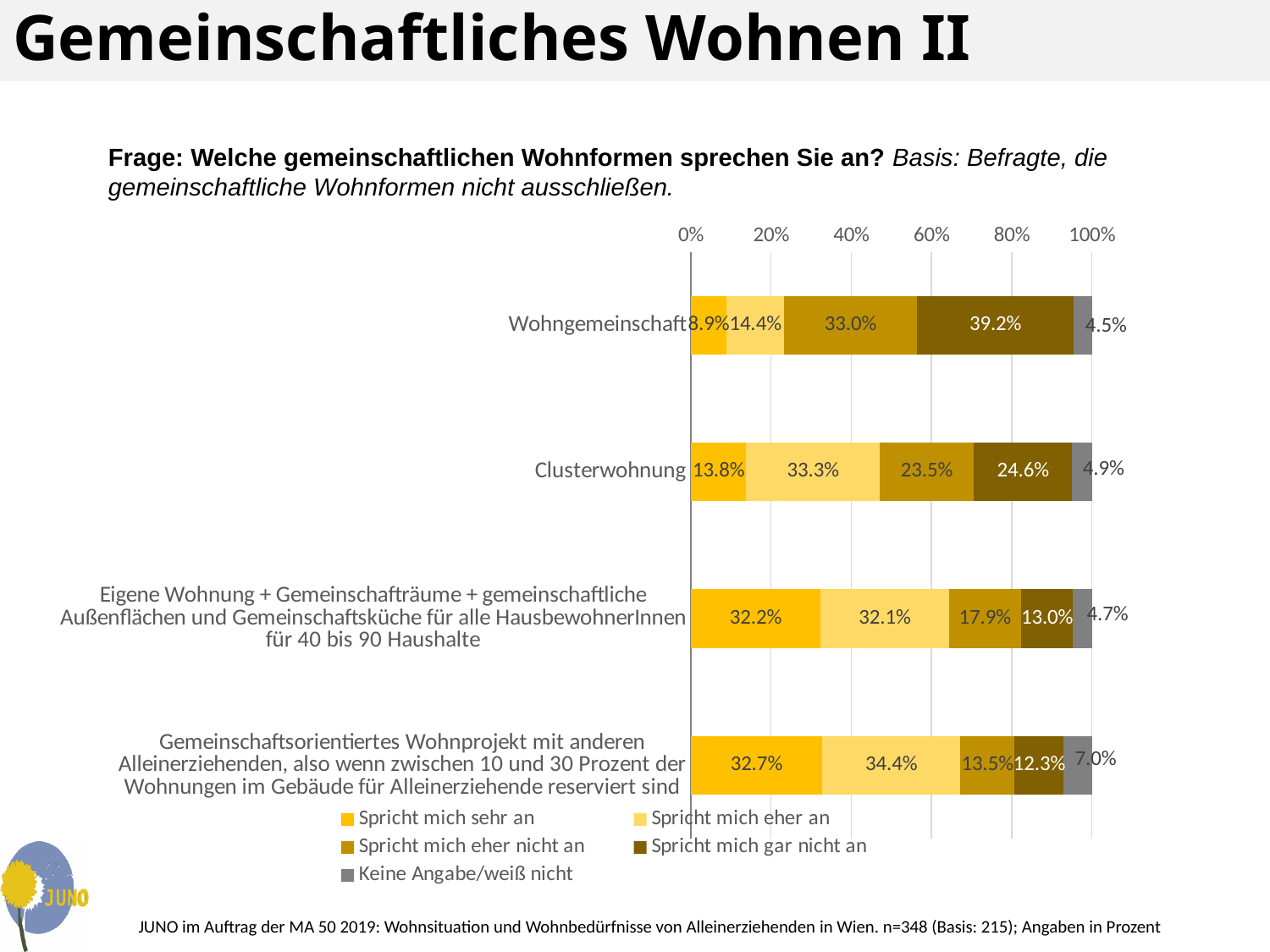
Which has the larger 'Spricht mich eher an' value: Wohngemeinschaft or Clusterwohnung? Clusterwohnung What is the value of 'Spricht mich gar nicht an' for Wohngemeinschaft? 39.2% What is the value of 'Spricht mich sehr an' for 'Eigene Wohnung + Gemeinschafträume + gemeinschaftliche Außenflächen'? 32.2% Which housing form has the highest value for 'Spricht mich gar nicht an'? Wohngemeinschaft How many housing forms (categories) are shown in the chart? 4 Which housing form has the lowest value for 'Spricht mich sehr an'? Wohngemeinschaft How many series does the legend list? 5 What is the difference between the 'Spricht mich gar nicht an' values for Wohngemeinschaft and Clusterwohnung? 14.6 percentage points Which series is shown in grey in the legend? Keine Angabe/weiß nicht What kind of chart is shown on the slide? Stacked bar chart What is the value of 'Spricht mich eher an' for Clusterwohnung? 33.3% What is the value of 'Keine Angabe/weiß nicht' for the Gemeinschaftsorientiertes Wohnprojekt mit anderen Alleinerziehenden? 7.0%